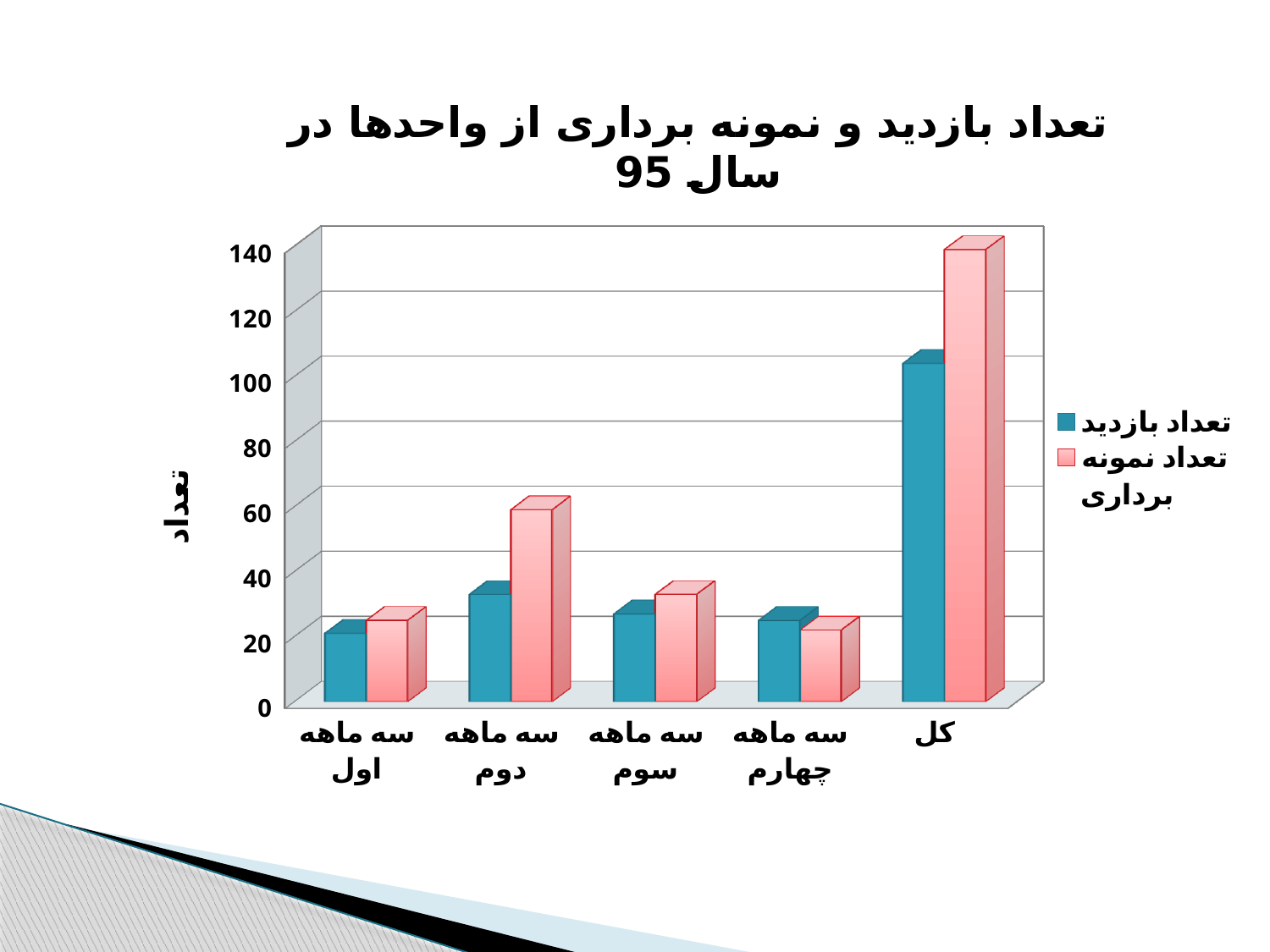
What kind of chart is shown on the slide? bar chart For سه ماهه دوم, which is larger: تعداد بازدید or تعداد نمونه برداری? تعداد نمونه برداری Is the value of تعداد نمونه برداری for سه ماهه دوم greater or less than 40? greater Which category has the highest value for تعداد نمونه برداری? کل Is the value of تعداد نمونه برداری for کل greater or less than 120? greater What is the label on the vertical axis of the chart? تعداد Is the value of تعداد بازدید for سه ماهه اول greater or less than 40? less How many categories are shown on the x axis of the chart? 5 Which category has the highest value for تعداد بازدید? کل How many series does the chart's legend list? 2 Which is larger: تعداد نمونه برداری for سه ماهه دوم or for سه ماهه سوم? سه ماهه دوم